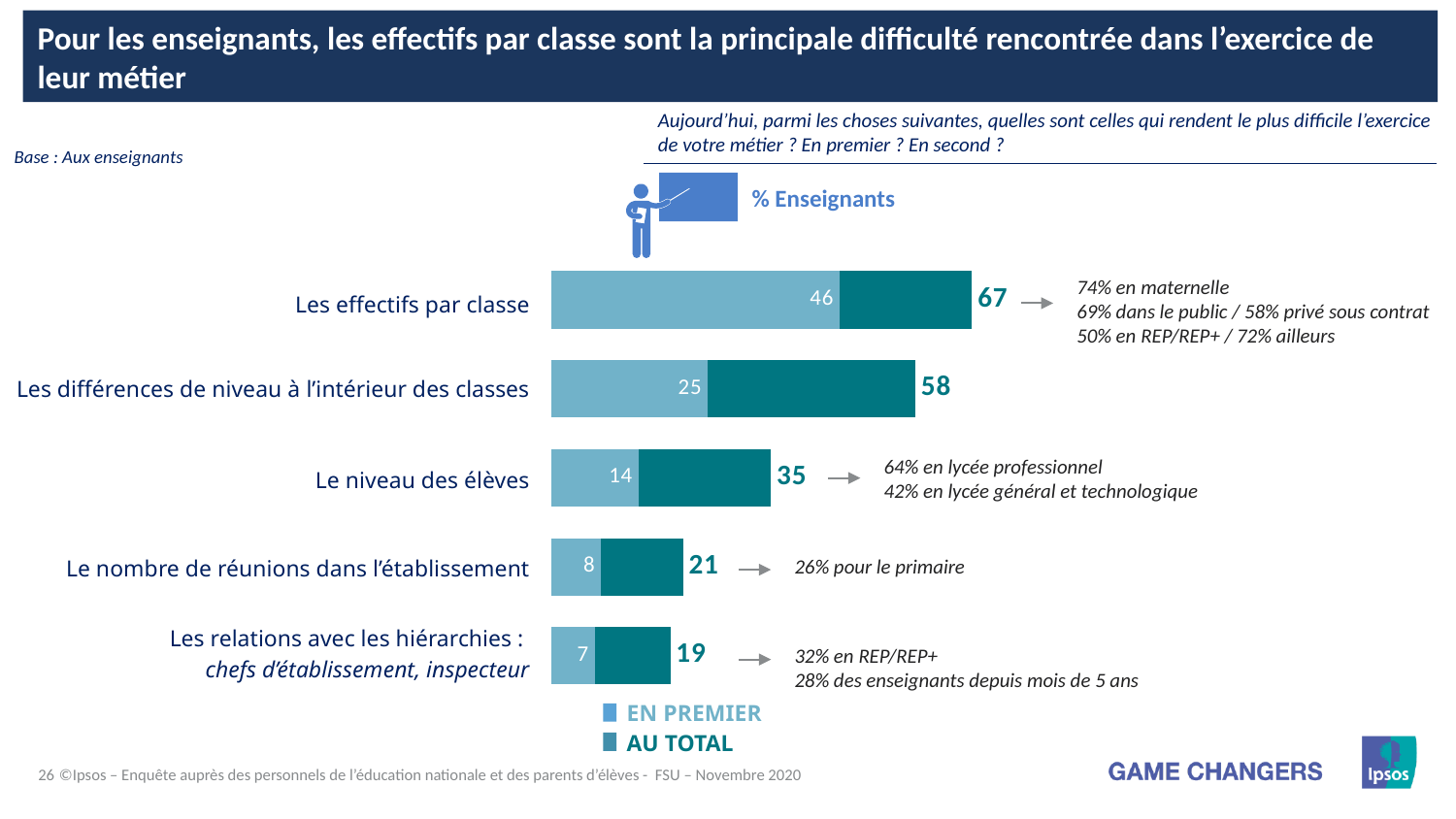
How many categories are shown in the chart? 5 What is the 'AU TOTAL' value for 'Les effectifs par classe'? 67 What is the difference between the 'AU TOTAL' values for 'Les effectifs par classe' and 'Les différences de niveau à l'intérieur des classes'? 9 How many series does the legend list? 2 What is the 'EN PREMIER' value for 'Le nombre de réunions dans l'établissement'? 8 What is the 'EN PREMIER' value for 'Les différences de niveau à l'intérieur des classes'? 25 What is the 'AU TOTAL' value for 'Le niveau des élèves'? 35 Which is larger: the 'EN PREMIER' value for 'Le niveau des élèves' or for 'Le nombre de réunions dans l'établissement'? Le niveau des élèves What are the two series named in the legend? EN PREMIER and AU TOTAL What kind of chart is shown on the slide? Bar chart Which category has the highest 'AU TOTAL' value? Les effectifs par classe Which category has the lowest 'EN PREMIER' value? Les relations avec les hiérarchies : chefs d'établissement, inspecteur